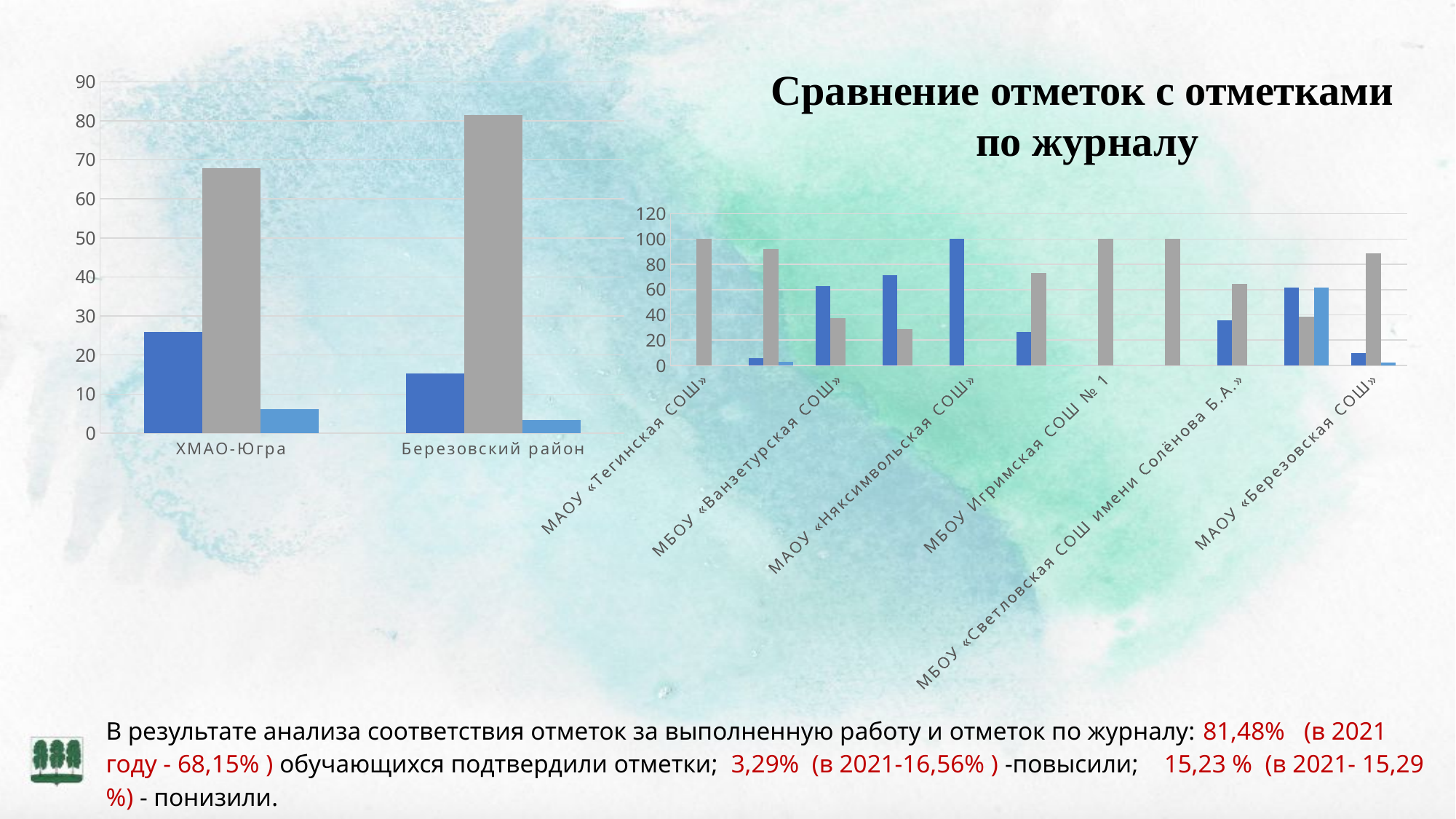
What is the title of the right chart? Сравнение отметок с отметками по журналу In the right chart, is the grey bar for МАОУ «Тегинская СОШ» greater or less than 80? greater In the left chart, which category has the taller dark blue bar, ХМАО-Югра or Березовский район? ХМАО-Югра In the left chart, is the dark blue bar for ХМАО-Югра greater or less than 20? greater In the left chart, how many bars are shown for ХМАО-Югра? 3 In the left chart, is the grey bar for Березовский район greater or less than 70? greater In the left chart, which category has the taller grey bar, ХМАО-Югра or Березовский район? Березовский район How many categories are shown on the x axis of the left chart? 2 What kind of chart is the left chart with the categories ХМАО-Югра and Березовский район? bar chart